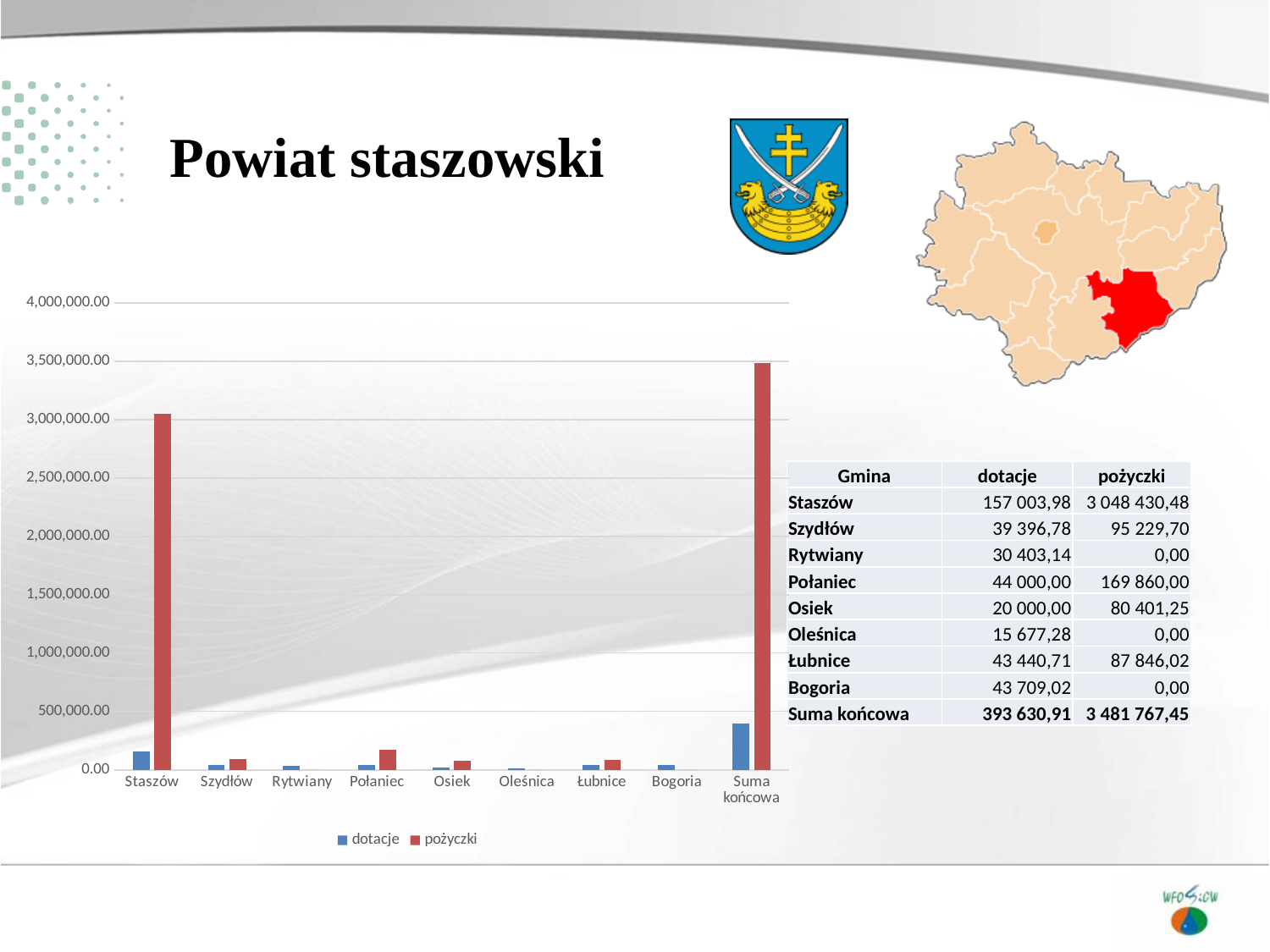
According to the table on the slide, what is the dotacje value for Połaniec? 44 000,00 What kind of chart is shown on the slide? bar chart Which is larger, the pożyczki value for Staszów or the pożyczki value for Połaniec? Staszów Is the pożyczki value for Suma końcowa greater or less than 3,000,000.00? greater Which categories show no pożyczki bar in the chart? Rytwiany, Oleśnica, Bogoria Is the dotacje value for Suma końcowa greater or less than 500,000.00? less What colour represents the pożyczki series in the chart? red How many categories are shown along the x axis of the chart? 9 Which category has the tallest pożyczki bar in the chart? Suma końcowa How many series does the chart legend list? 2 According to the table on the slide, what is the pożyczki value for Staszów? 3 048 430,48 Is the pożyczki value for Staszów greater or less than 2,500,000.00? greater